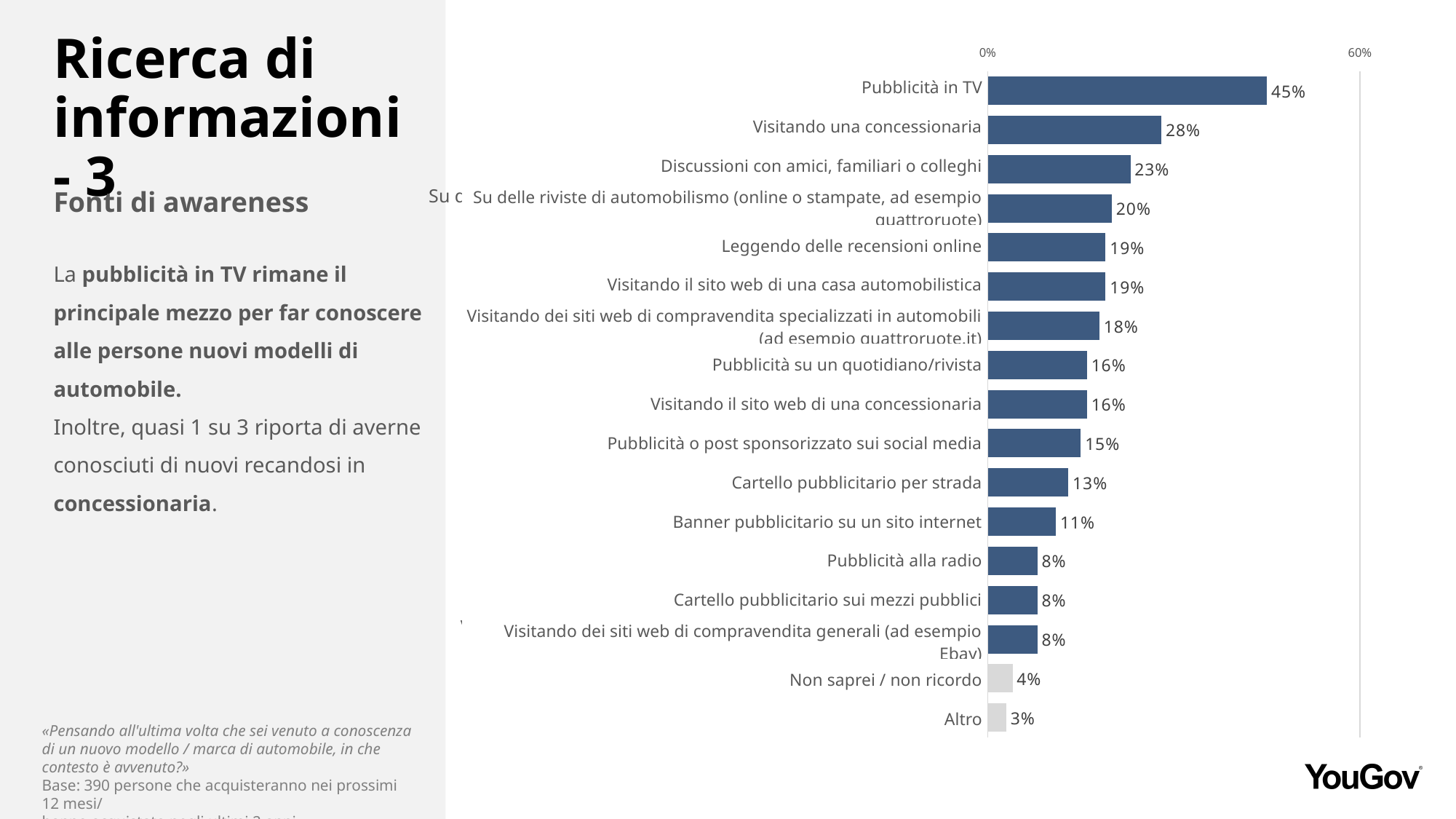
What is the difference between "Discussioni con amici, familiari o colleghi" and "Pubblicità alla radio"? 15% What is the value for "Pubblicità in TV"? 45% What is the value for "Non saprei / non ricordo"? 4% What is the value for "Visitando una concessionaria"? 28% What is the value for "Cartello pubblicitario per strada"? 13% How many categories are shown in the chart? 17 Which is larger: "Banner pubblicitario su un sito internet" or "Pubblicità o post sponsorizzato sui social media"? Pubblicità o post sponsorizzato sui social media Which category has the lowest value? Altro What is the difference between "Pubblicità in TV" and "Visitando una concessionaria"? 17% Which category has the highest value? Pubblicità in TV What kind of chart is shown on the slide? Bar chart What is the maximum value shown on the chart's axis? 60%